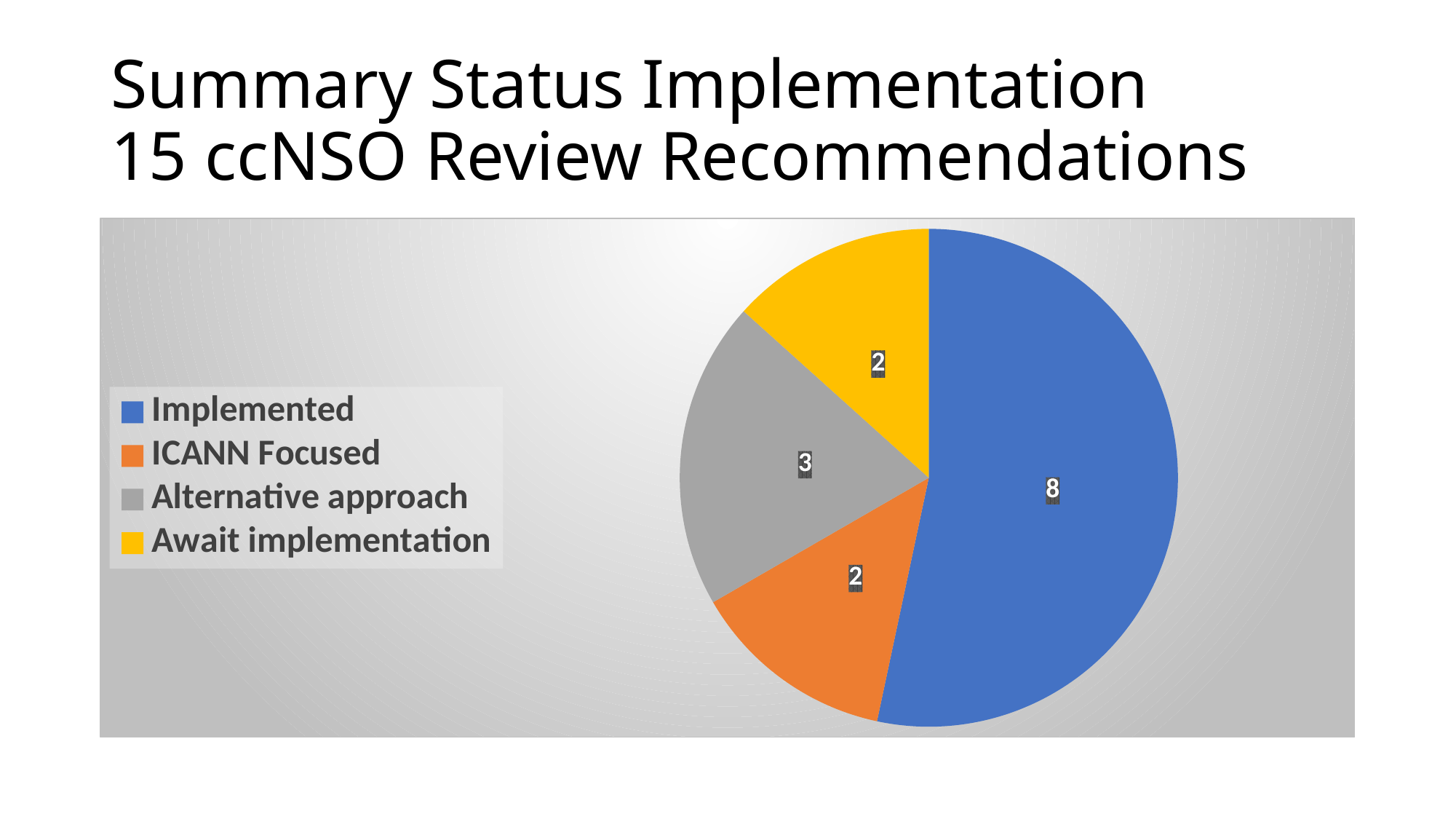
What is the total of all slices in the pie chart? 15 How many categories does the pie chart show? 4 Which is larger, the value for Implemented or the value for Alternative approach? Implemented Which legend entry is shown in orange? ICANN Focused What colour is the Await implementation slice? yellow What is the value for Alternative approach? 3 What is the value for Await implementation? 2 How many recommendations are labelled as Implemented? 8 What kind of chart is shown on the slide? pie chart What is the difference between the Implemented value and the Alternative approach value? 5 Which category has the largest slice of the pie? Implemented What is the value for ICANN Focused? 2